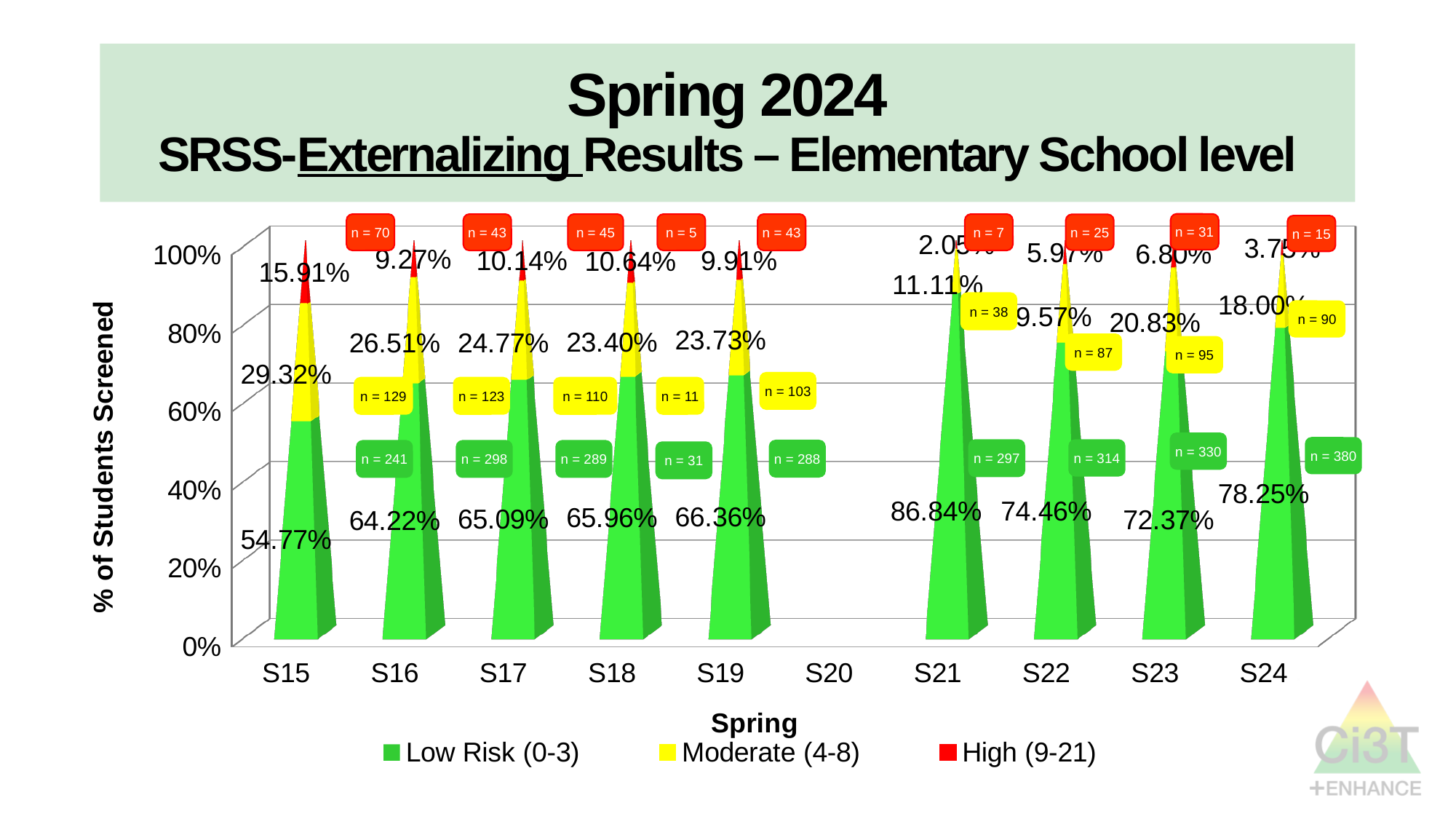
Which spring has the lowest Low Risk (0-3) percentage? S15 What kind of chart is shown on the slide? Stacked bar chart Which spring label on the x axis has no data plotted? S20 How many series does the legend list? 3 What is the High (9-21) percentage for S18? 10.64% What is the Low Risk (0-3) percentage for S15? 54.77% What is the difference between the Low Risk (0-3) percentages for S19 and S18? 0.40% Which spring has the highest High (9-21) percentage? S15 Which spring has the highest Low Risk (0-3) percentage? S21 What is the Moderate (4-8) percentage for S16? 26.51% Which is larger, the Moderate (4-8) percentage for S17 or for S18? S17 What is the n value shown for the Low Risk (0-3) group in S24? n = 380